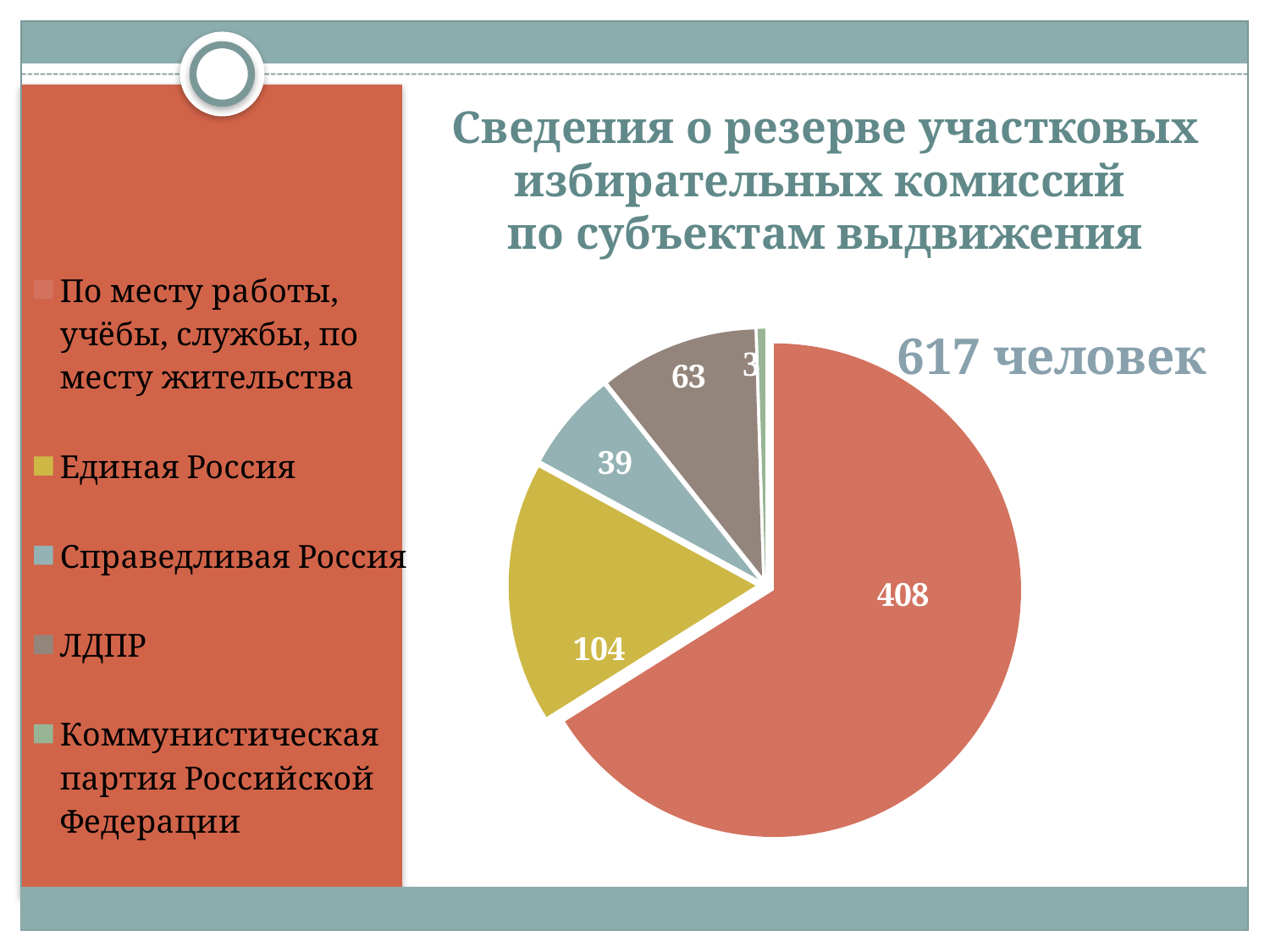
What is the value for ЛДПР? 63 How many categories does the legend list? 5 What is the value for Справедливая Россия? 39 Which category has the smallest slice of the pie? Коммунистическая партия Российской Федерации How many people are in the reserve nominated by Единая Россия? 104 What total number of people is stated next to the pie chart? 617 человек What is the value for Коммунистическая партия Российской Федерации? 3 What kind of chart is shown on the slide? pie chart What is the value for the slice 'По месту работы, учёбы, службы, по месту жительства'? 408 Which is larger, the value for ЛДПР or the value for Справедливая Россия? ЛДПР Which category has the largest slice of the pie? По месту работы, учёбы, службы, по месту жительства What is the difference between the values for Единая Россия and ЛДПР? 41